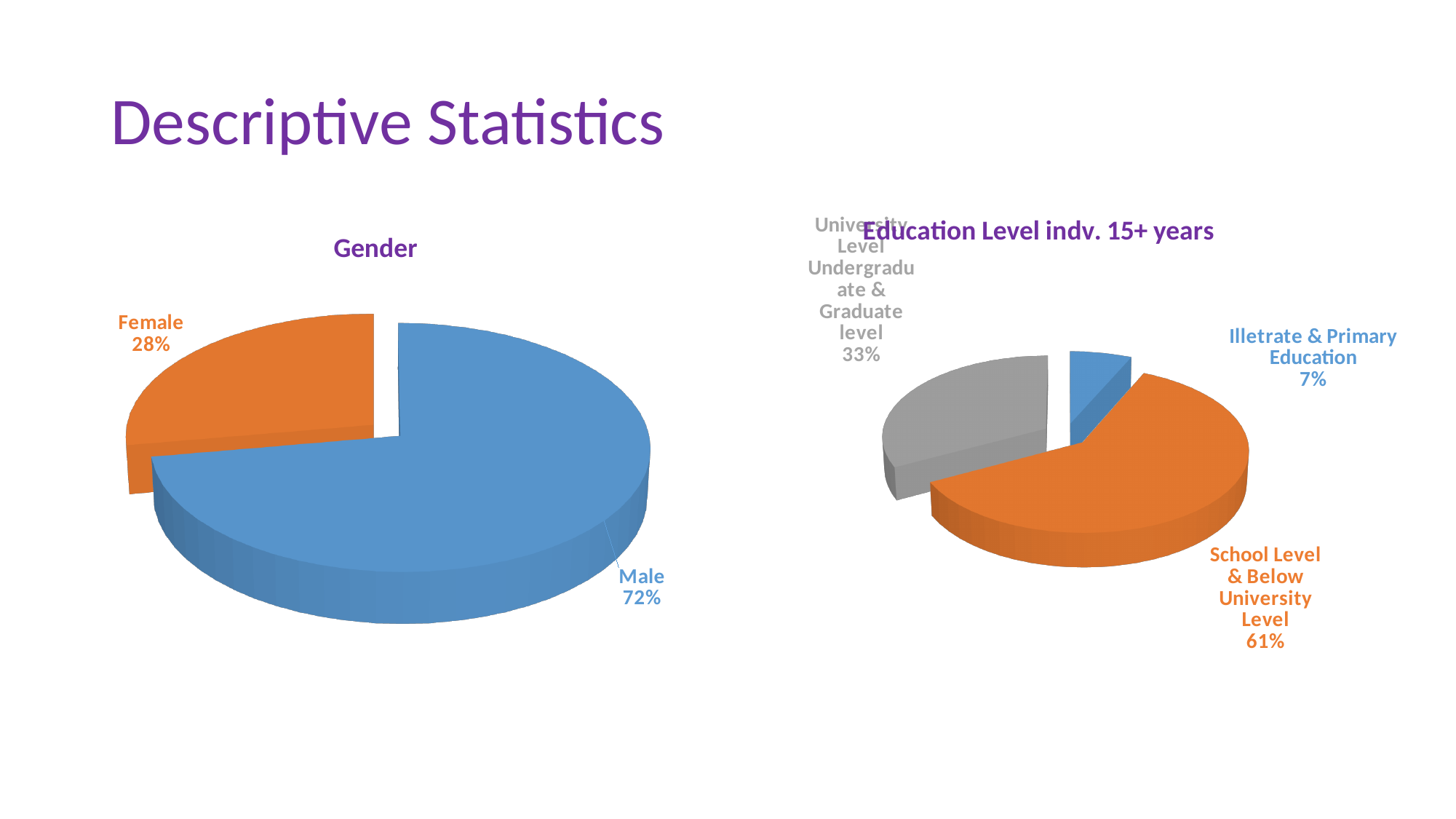
How many slices does the Gender chart have? 2 In the Education Level indv. 15+ years chart, what share is School Level & Below University Level? 61% In the Education Level indv. 15+ years chart, what share is Illetrate & Primary Education? 7% In the Education Level indv. 15+ years chart, which category has the smallest slice? Illetrate & Primary Education In the Gender chart, what share is Female? 28% In the Education Level indv. 15+ years chart, which is larger: University Level Undergraduate & Graduate level or Illetrate & Primary Education? University Level Undergraduate & Graduate level In the Gender chart, what share is Male? 72% In the Education Level indv. 15+ years chart, what is the difference between School Level & Below University Level and University Level Undergraduate & Graduate level? 28% In the Gender chart, what is the difference between the Male and Female shares? 44% How many slices does the Education Level indv. 15+ years chart have? 3 What kind of chart is the Gender chart? Pie chart In the Gender chart, which category has the largest slice? Male